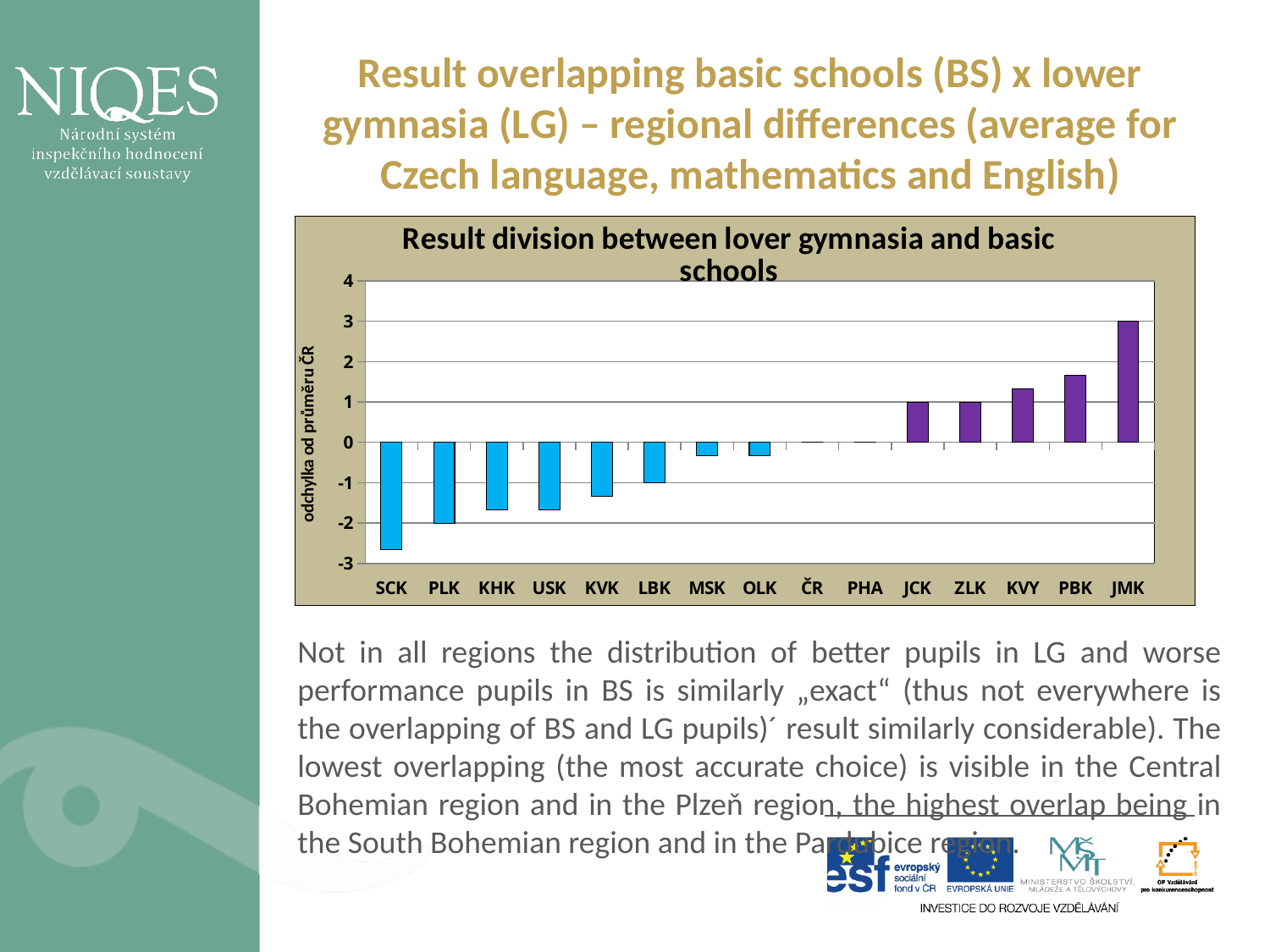
Is the value for PBK greater or less than 1? greater Which category has the highest value in the chart? JMK What is the title of the chart? Result division between lover gymnasia and basic schools Is the value for KVK greater or less than -1? less Which has the larger value, JMK or PBK? JMK Is the value for JMK greater or less than 2? greater How many regions (categories) are plotted on the x axis of the chart? 15 Which category has the lowest value in the chart? SCK Do the values generally rise or fall moving from left to right along the x axis? rise What kind of chart is shown on the slide? bar chart